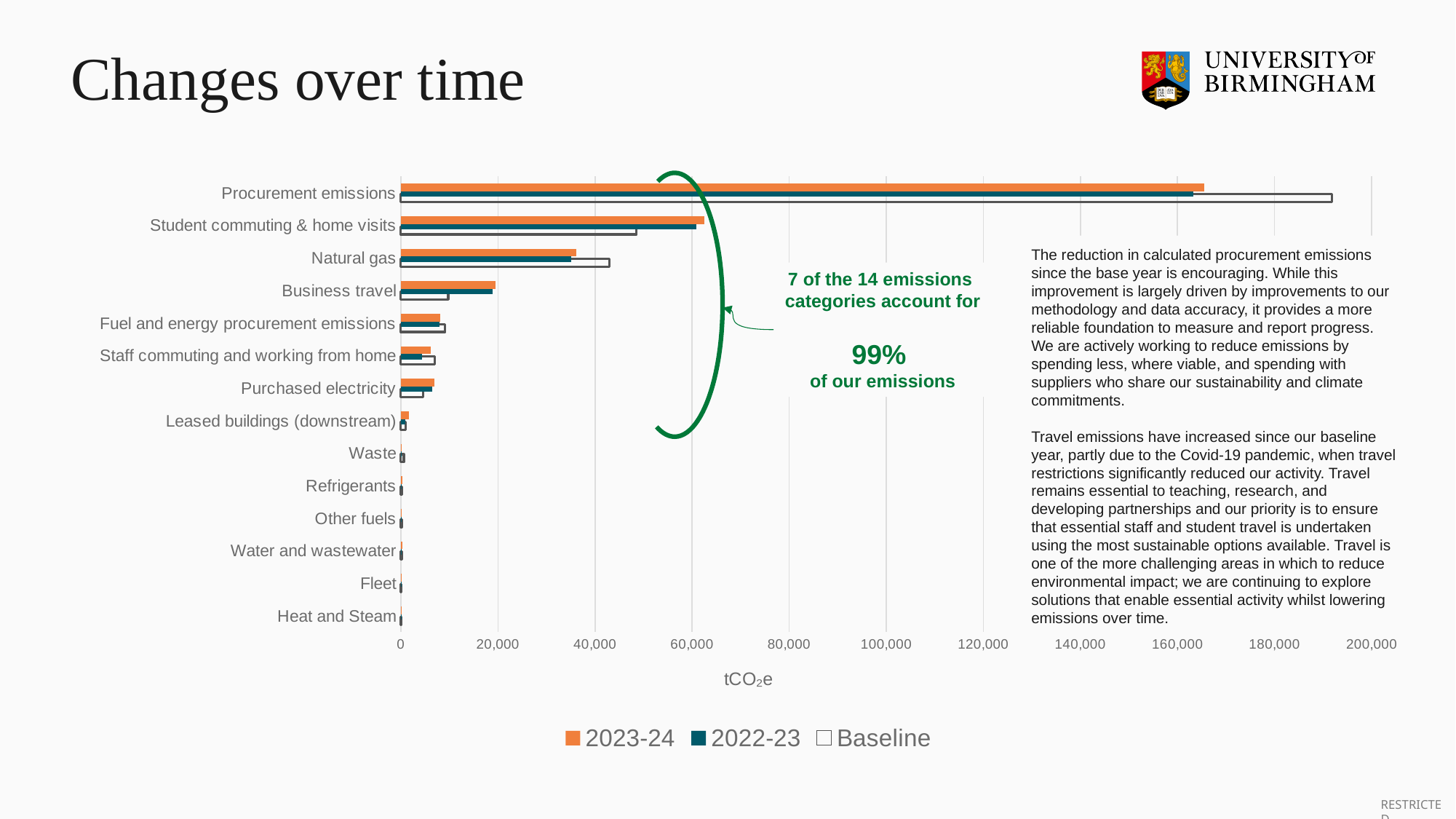
What kind of chart is shown on the slide? bar chart How many emissions categories are listed on the chart's vertical axis? 14 Which category has the highest Baseline value? Procurement emissions What is the label on the chart's horizontal axis? tCO2e For Procurement emissions, which is larger: the Baseline value or the 2023-24 value? Baseline Is the Baseline value for Student commuting & home visits greater or less than 40,000? greater Is the 2023-24 value for Natural gas greater or less than 40,000? less Which category has the highest 2023-24 value? Procurement emissions For Business travel, which is larger: the 2023-24 value or the Baseline value? 2023-24 Is the Baseline value for Procurement emissions greater or less than 180,000? greater How many series does the chart legend list? 3 Which series is shown with orange bars in the legend? 2023-24